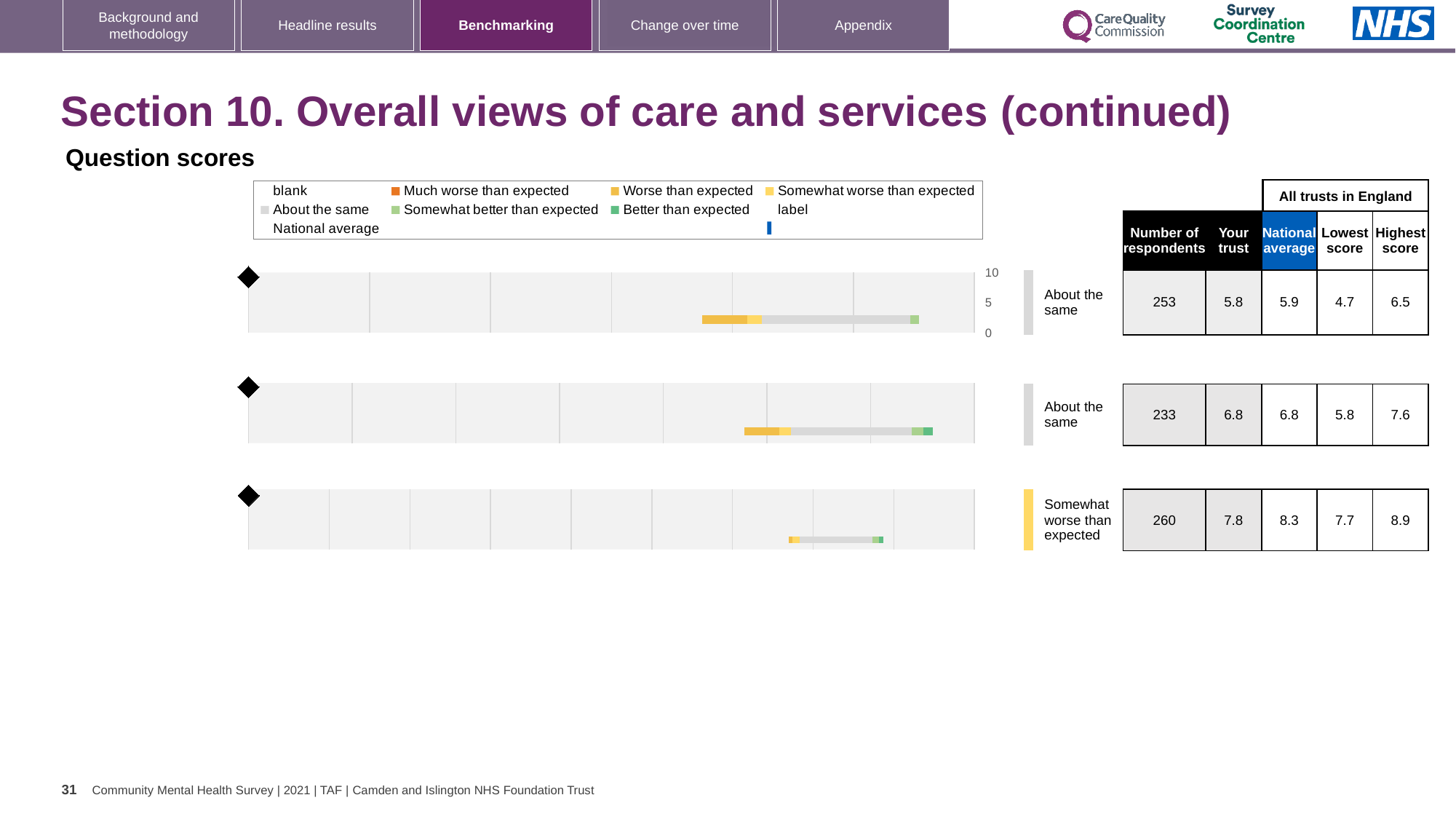
For the top chart, what is the lowest score across all trusts in England? 4.7 For the bottom chart, what is the highest score across all trusts in England? 8.9 For the top chart, what is the 'Your trust' score shown in the table? 5.8 For the bottom chart, what is the difference between the national average and the 'Your trust' score? 0.5 How many question score charts are shown on the slide? 3 For the bottom chart, how many respondents are listed? 260 For the middle chart, what is the national average score? 6.8 What kind of chart is used on this slide to show the question scores? bar chart For the middle chart, what is the difference between the highest and lowest scores across all trusts in England? 1.8 For the top chart, which is larger: the 'Your trust' score or the national average? National average Which chart (top, middle or bottom) has the highest 'Your trust' score? bottom What benchmark category label is shown next to the bottom chart? Somewhat worse than expected